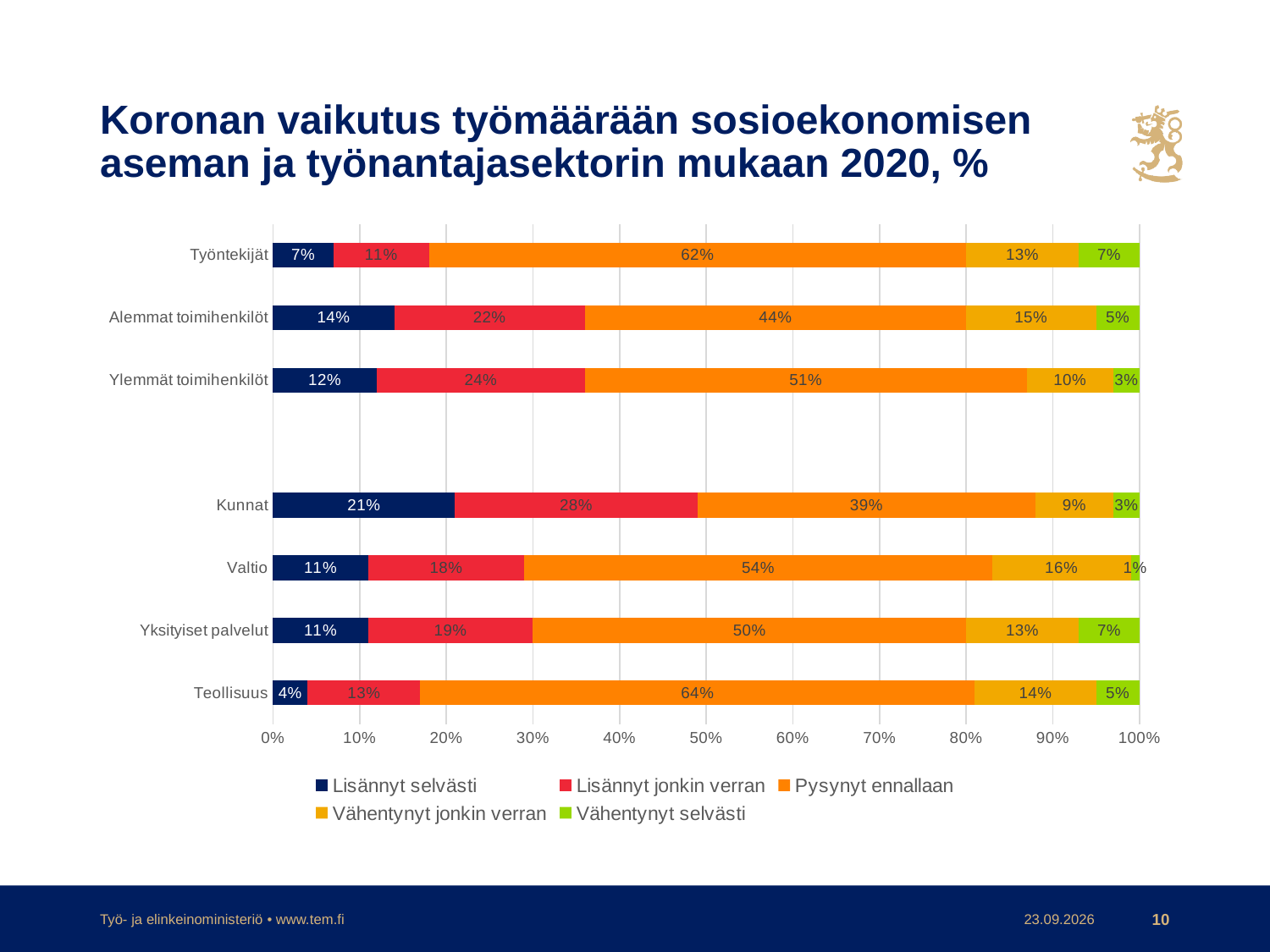
Which category has the lowest value for "Lisännyt selvästi"? Teollisuus How many categories are plotted on the chart? 7 What is the value of "Lisännyt jonkin verran" for Ylemmät toimihenkilöt? 24% What is the value of "Vähentynyt jonkin verran" for Valtio? 16% What is the value of "Pysynyt ennallaan" for Työntekijät? 62% Which category has the highest value for "Pysynyt ennallaan"? Teollisuus How many series does the legend list? 5 Which series is shown in dark blue in the legend? Lisännyt selvästi What is the value of "Lisännyt selvästi" for Kunnat? 21% What kind of chart is shown on the slide? Stacked bar chart Which is larger: the "Vähentynyt selvästi" value for Työntekijät or for Valtio? Työntekijät What is the difference between the "Lisännyt jonkin verran" values for Kunnat and Teollisuus? 15%